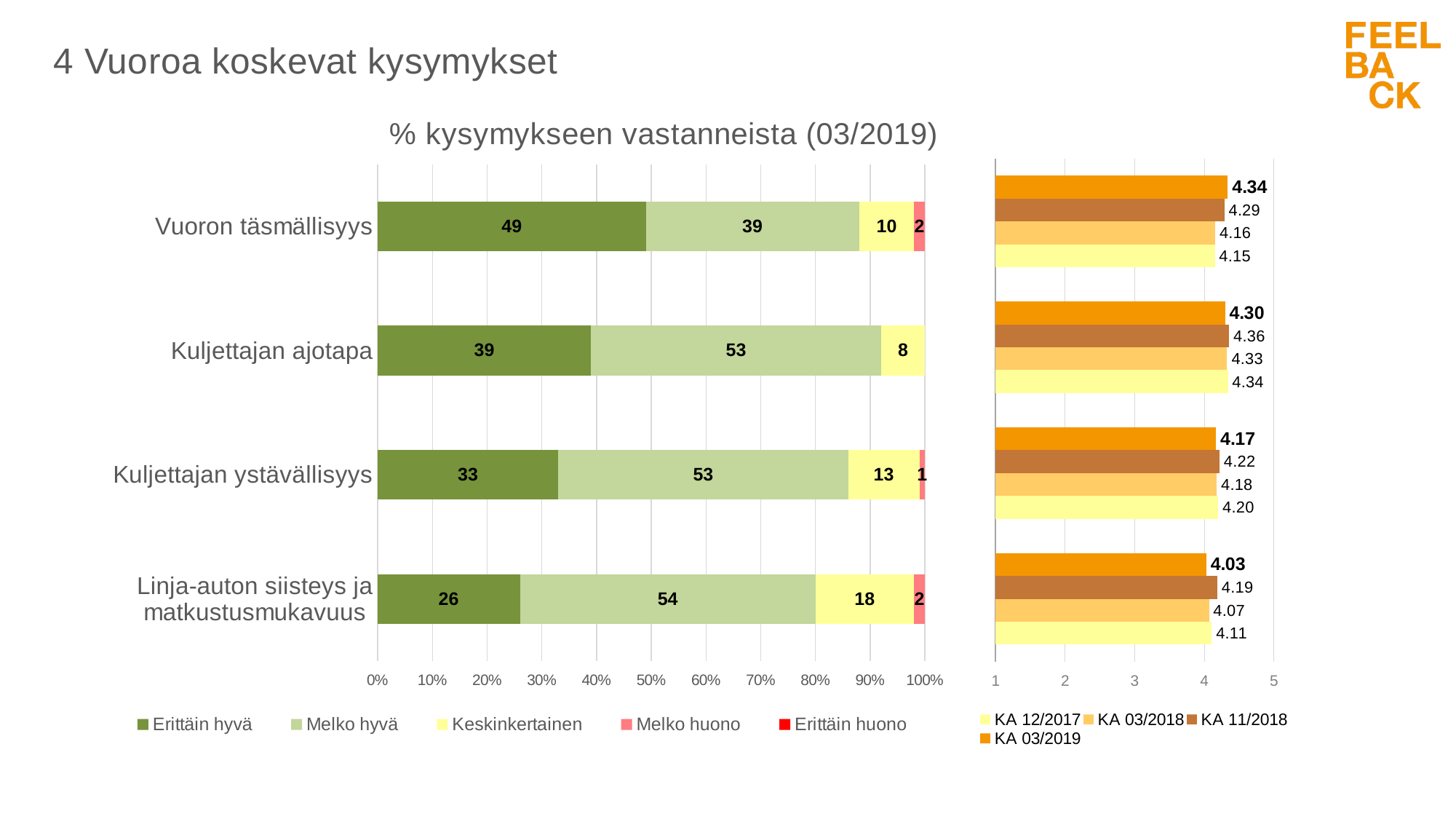
In the left chart '% kysymykseen vastanneista (03/2019)', which category has the highest 'Erittäin hyvä' value? Vuoron täsmällisyys In the left chart '% kysymykseen vastanneista (03/2019)', what is the value of 'Keskinkertainen' for 'Linja-auton siisteys ja matkustusmukavuus'? 18 In the right chart, what is the 'KA 11/2018' value for 'Kuljettajan ajotapa'? 4.36 What kind of chart is the left chart '% kysymykseen vastanneista (03/2019)'? Stacked bar chart In the left chart '% kysymykseen vastanneista (03/2019)', how much larger is the 'Melko hyvä' value than the 'Erittäin hyvä' value for 'Kuljettajan ajotapa'? 14 How many series does the legend of the left chart '% kysymykseen vastanneista (03/2019)' list? 5 How many series does the legend of the right chart list? 4 In the left chart '% kysymykseen vastanneista (03/2019)', which category has the lowest 'Erittäin hyvä' value? Linja-auton siisteys ja matkustusmukavuus In the right chart, what is the 'KA 03/2019' value for 'Kuljettajan ystävällisyys'? 4.17 In the right chart, which category has the highest 'KA 03/2019' value? Vuoron täsmällisyys In the left chart '% kysymykseen vastanneista (03/2019)', what is the value of 'Erittäin hyvä' for 'Vuoron täsmällisyys'? 49 How many categories are shown in the left chart '% kysymykseen vastanneista (03/2019)'? 4